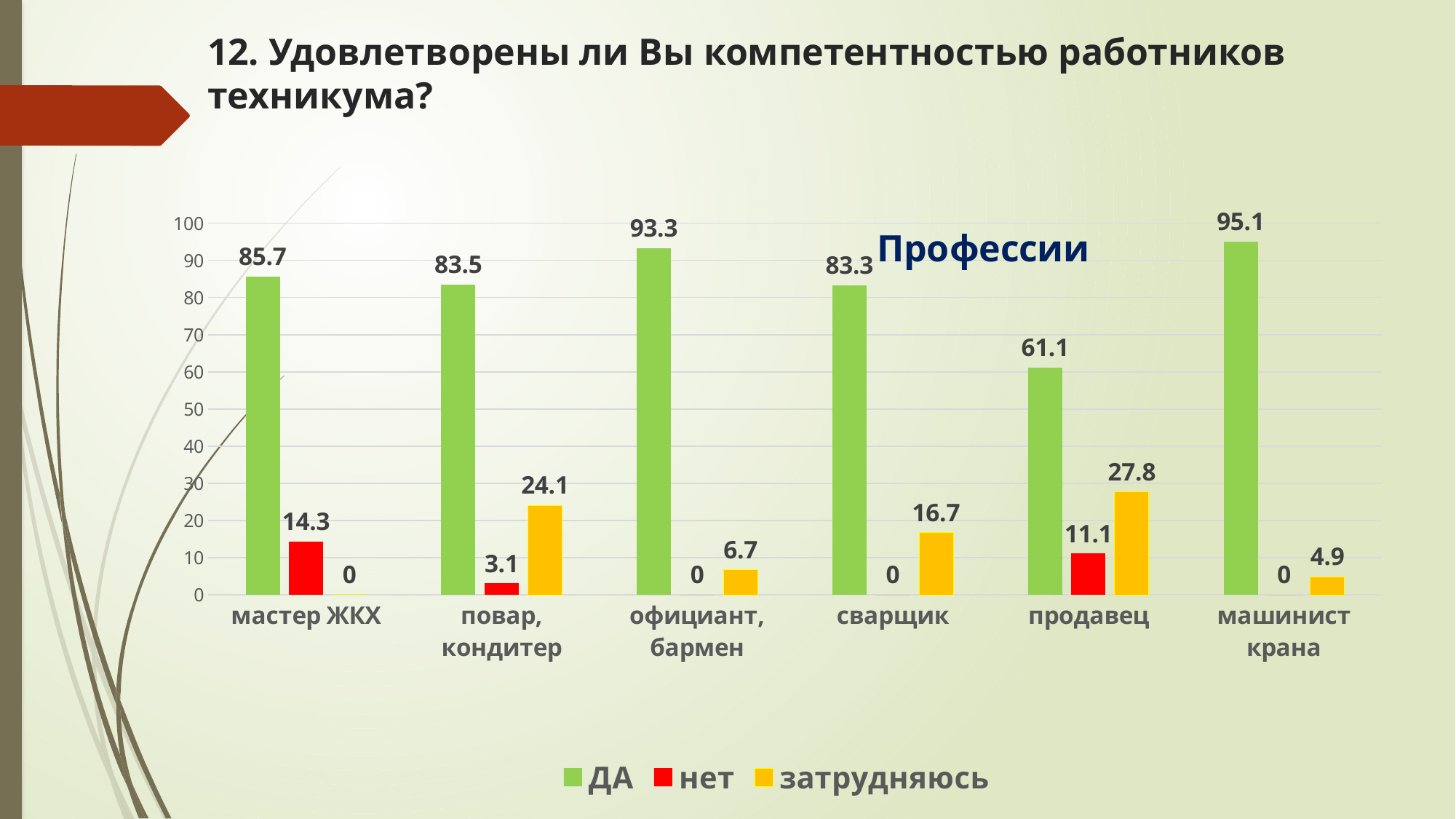
How many series does the legend list? 3 Which profession has the lowest ДА value? продавец What is the difference between the ДА values for официант, бармен and сварщик? 10 What is the value of затрудняюсь for повар, кондитер? 24.1 What type of chart is shown on the slide? bar chart What is the value of ДА for машинист крана? 95.1 Which is larger: the нет value for мастер ЖКХ or the нет value for повар, кондитер? мастер ЖКХ Which profession has the highest затрудняюсь value? продавец What is the value of нет for продавец? 11.1 How many professions (categories) are shown on the x axis? 6 Which colour represents the series ДА in the legend? green Is the ДА value for продавец greater or less than 70? less